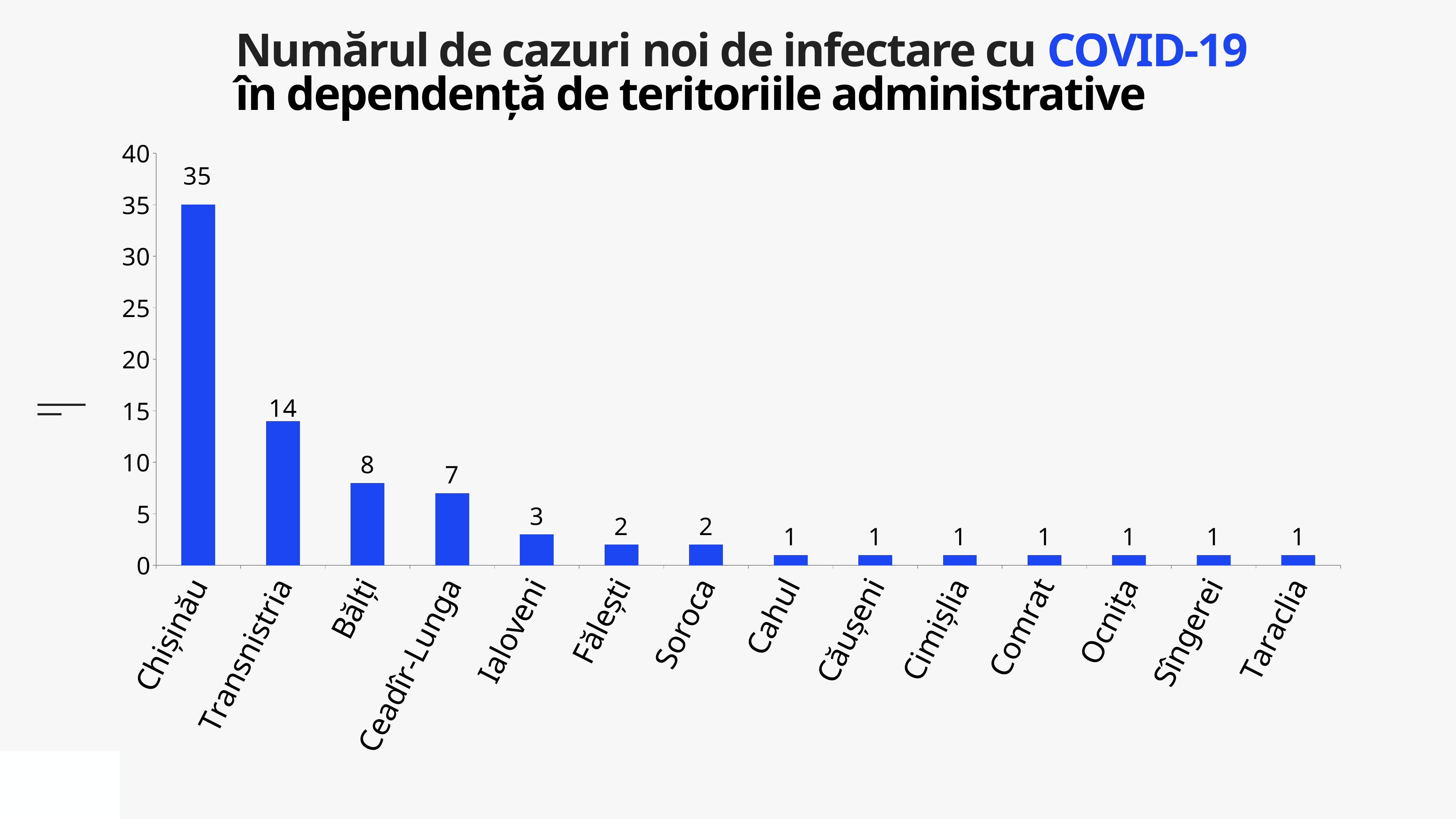
Is the value for Transnistria greater or less than 10? greater What is the difference between the values for Chișinău and Transnistria? 21 What is the value for Ceadîr-Lunga? 7 What is the value for Chișinău? 35 Do the values rise or fall from left to right along the x axis? fall How many categories are shown on the x axis? 14 What kind of chart is shown on the slide? bar chart Which is larger, the value for Bălți or the value for Soroca? Bălți Which category has the highest value? Chișinău What is the difference between the values for Bălți and Ceadîr-Lunga? 1 What is the value for Transnistria? 14 What is the value for Ialoveni? 3